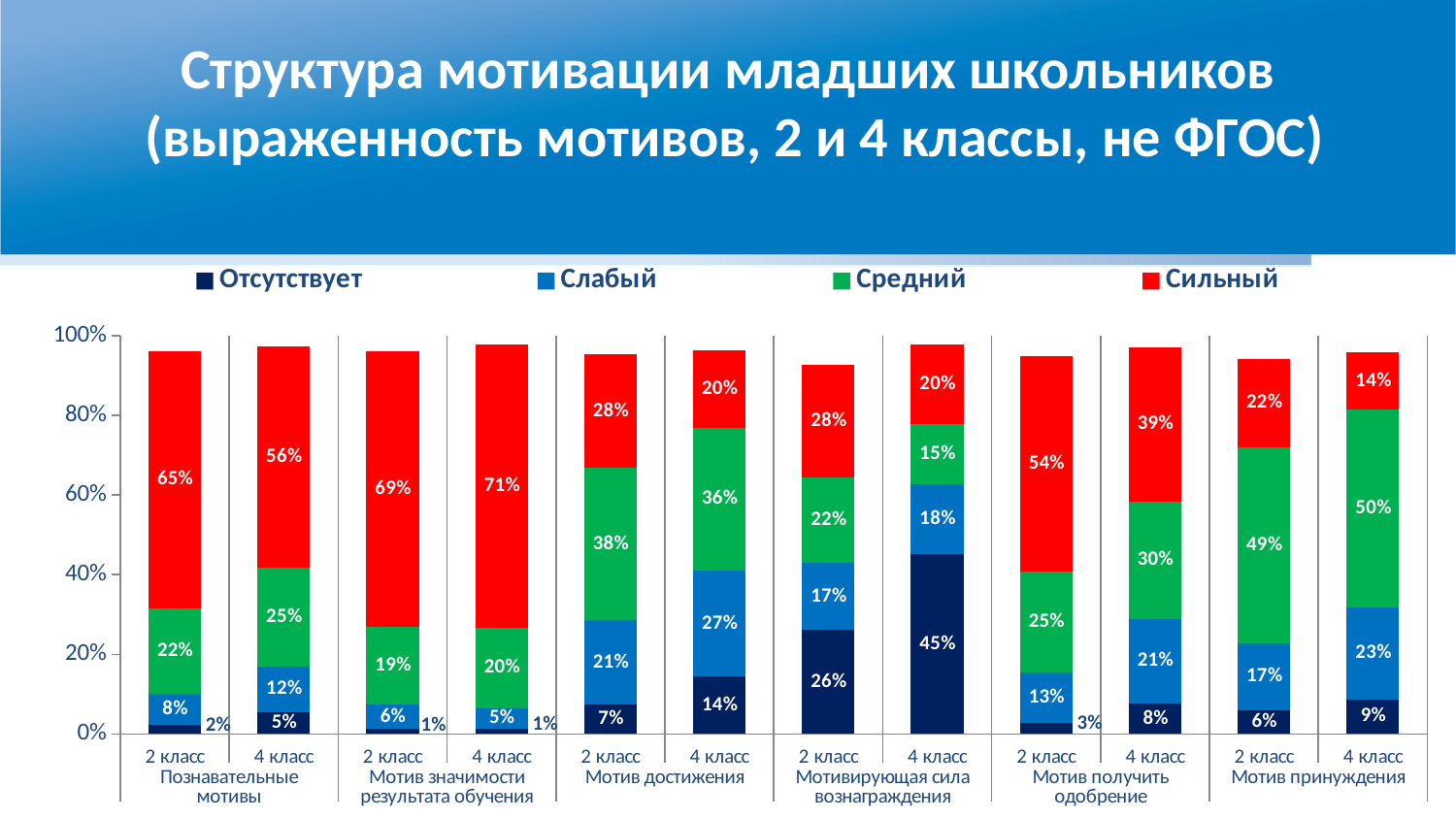
What is the total of the stacked bar for 4 класс in the Мотив достижения group? 97% Which bar has the lowest Сильный segment value? 4 класс, Мотив принуждения (14%) What is the value of the Сильный segment for 2 класс in the Познавательные мотивы group? 65% How many series does the legend list? 4 What is the value of the Слабый segment for 2 класс in the Мотив достижения group? 21% How many bars are plotted in the chart? 12 What is the difference between the Сильный values for 2 класс and 4 класс in the Мотив получить одобрение group? 15% Which is larger: the Средний value for 2 класс in Мотив достижения or the Средний value for 4 класс in Мотив достижения? 2 класс (38%) What is the value of the Средний segment for 4 класс in the Мотив принуждения group? 50% What type of chart is shown on the slide? Stacked bar chart What is the value of the Отсутствует segment for 4 класс in the Мотивирующая сила вознаграждения group? 45% Which bar has the highest Сильный segment value? 4 класс, Мотив значимости результата обучения (71%)